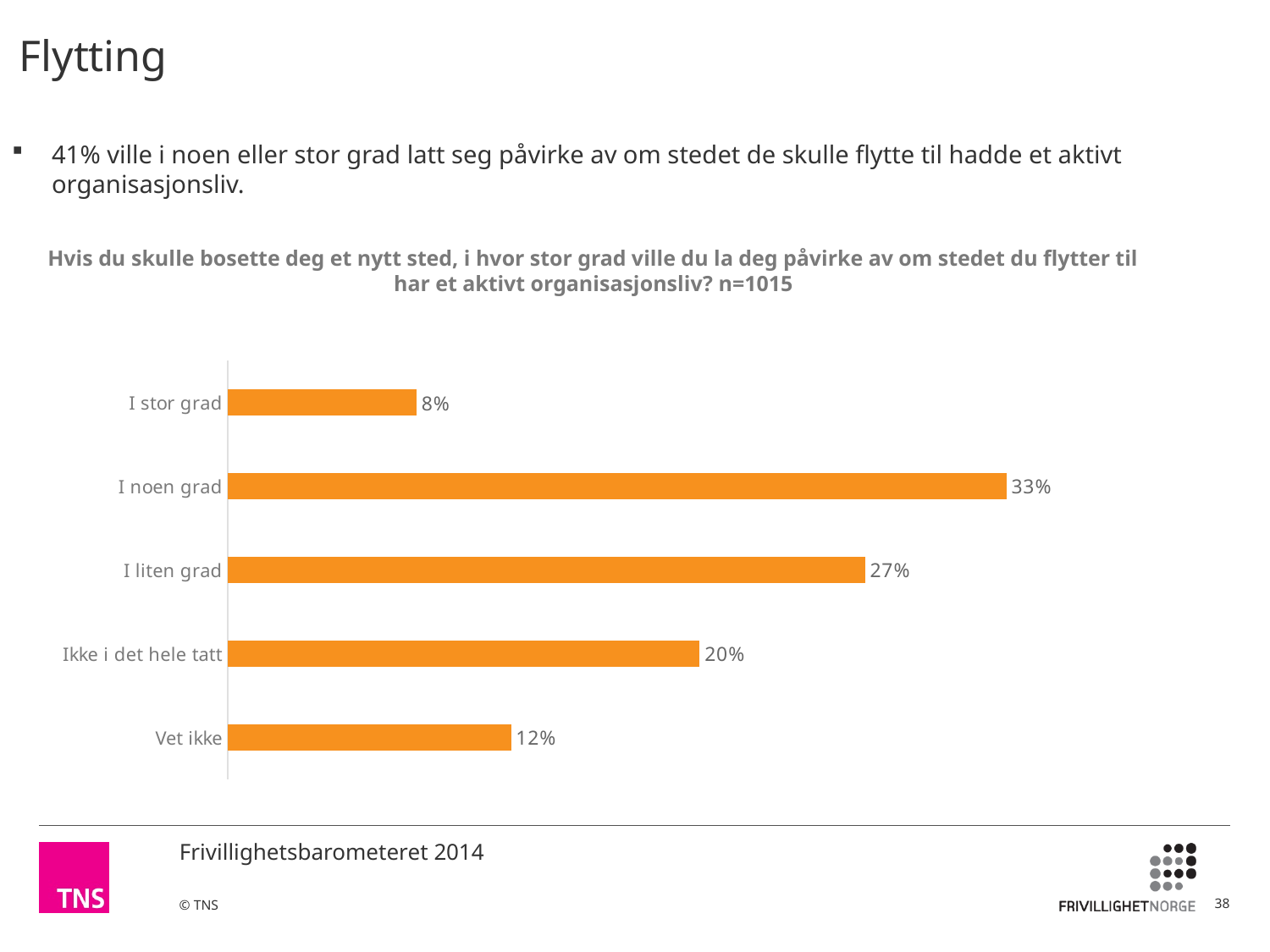
How many categories are shown in the chart? 5 Which category has the highest value? I noen grad What is the combined value of "I stor grad" and "I noen grad"? 41% What is the value for "I noen grad"? 33% What is the difference between the values for "Ikke i det hele tatt" and "I stor grad"? 12% What is the sample size (n) stated in the chart title? n=1015 Which is larger, the value for "I liten grad" or the value for "Vet ikke"? I liten grad What kind of chart is shown on the slide? Bar chart What is the value for "Vet ikke"? 12% What is the value for "Ikke i det hele tatt"? 20% What is the difference between the values for "I noen grad" and "I liten grad"? 6% Which category has the lowest value? I stor grad